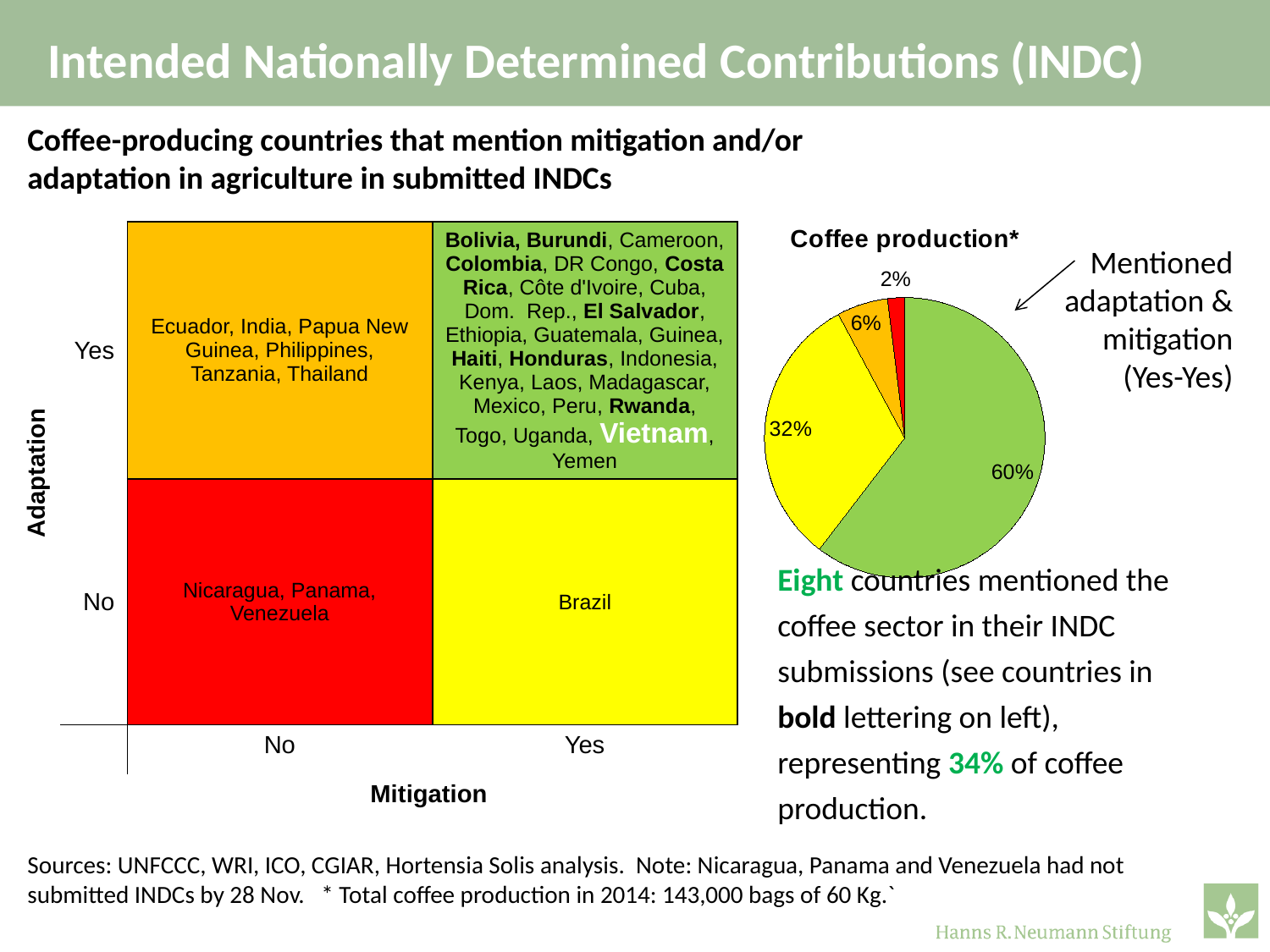
In the "Coffee production*" pie chart, what is the value of the orange slice? 6% What is the smallest slice of the "Coffee production*" pie chart? 2% What colour is the slice labelled 60% in the "Coffee production*" pie chart? green What kind of chart is the "Coffee production*" chart? pie chart What is the largest slice of the "Coffee production*" pie chart? 60% How many slices does the "Coffee production*" pie chart have? 4 In the "Coffee production*" pie chart, what is the value of the yellow slice? 32% In the "Coffee production*" pie chart, what is the difference between the green slice (60%) and the yellow slice (32%)? 28% In the "Coffee production*" pie chart, what share of coffee production comes from countries that mentioned adaptation & mitigation (Yes-Yes)? 60% In the "Coffee production*" pie chart, which is larger: the orange slice or the red slice? the orange slice (6%) In the "Coffee production*" pie chart, what do the orange and red slices add up to? 8% What is the title of the pie chart? Coffee production*